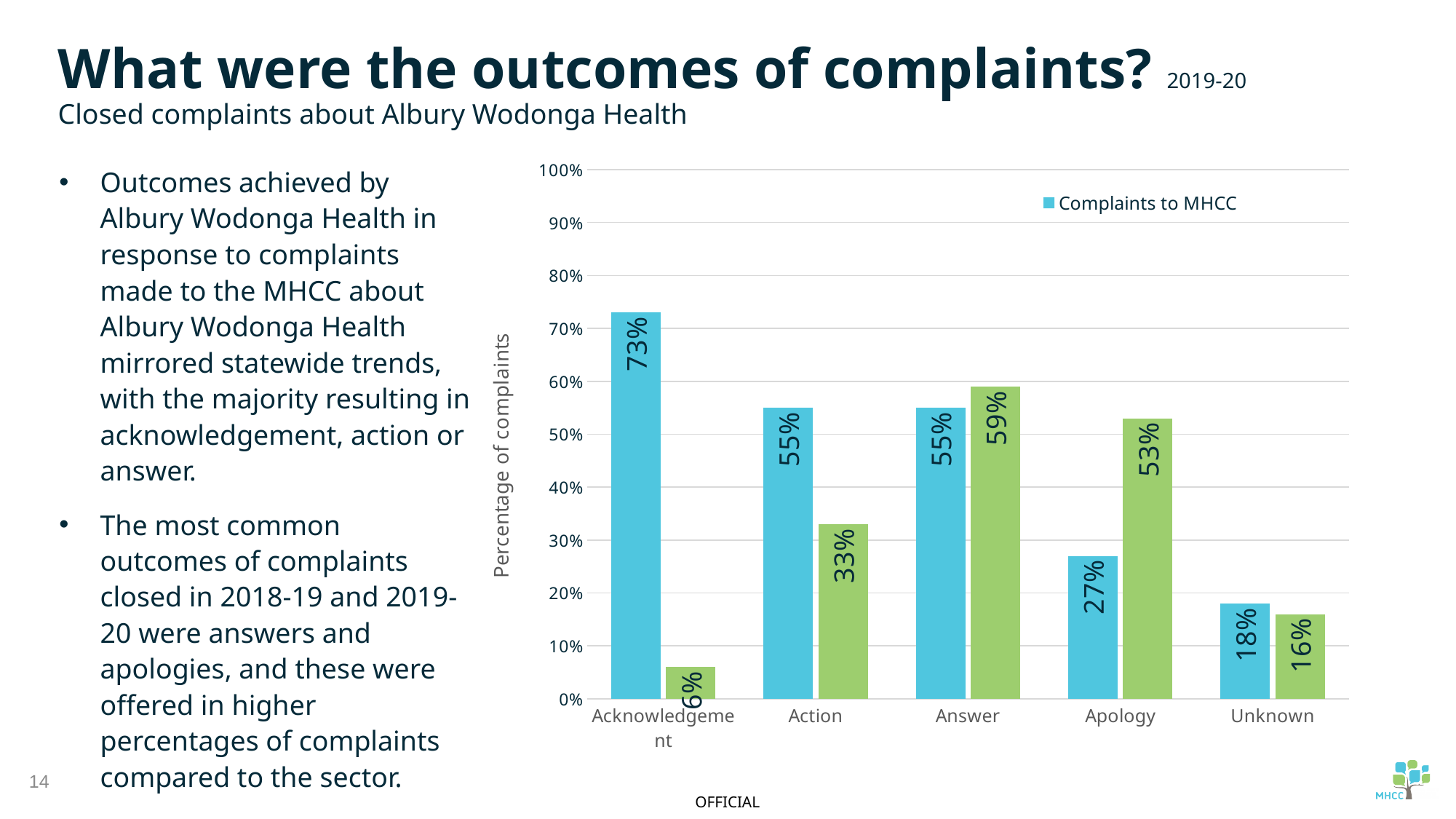
What is the value of the Complaints to MHCC bar for Acknowledgement? 73% Which category has the lowest green bar value? Acknowledgement What is the label of the y axis? Percentage of complaints What is the value of the green bar for Action? 33% What kind of chart is shown on the slide? bar chart For Apology, which is larger: the Complaints to MHCC bar or the green bar? the green bar What is the value of the Complaints to MHCC bar for Apology? 27% What is the value of the green bar for Answer? 59% Which category has the highest Complaints to MHCC value? Acknowledgement How many series does the legend list? 1 What is the difference between the Complaints to MHCC bar and the green bar for Acknowledgement? 67% How many categories are shown on the x axis? 5